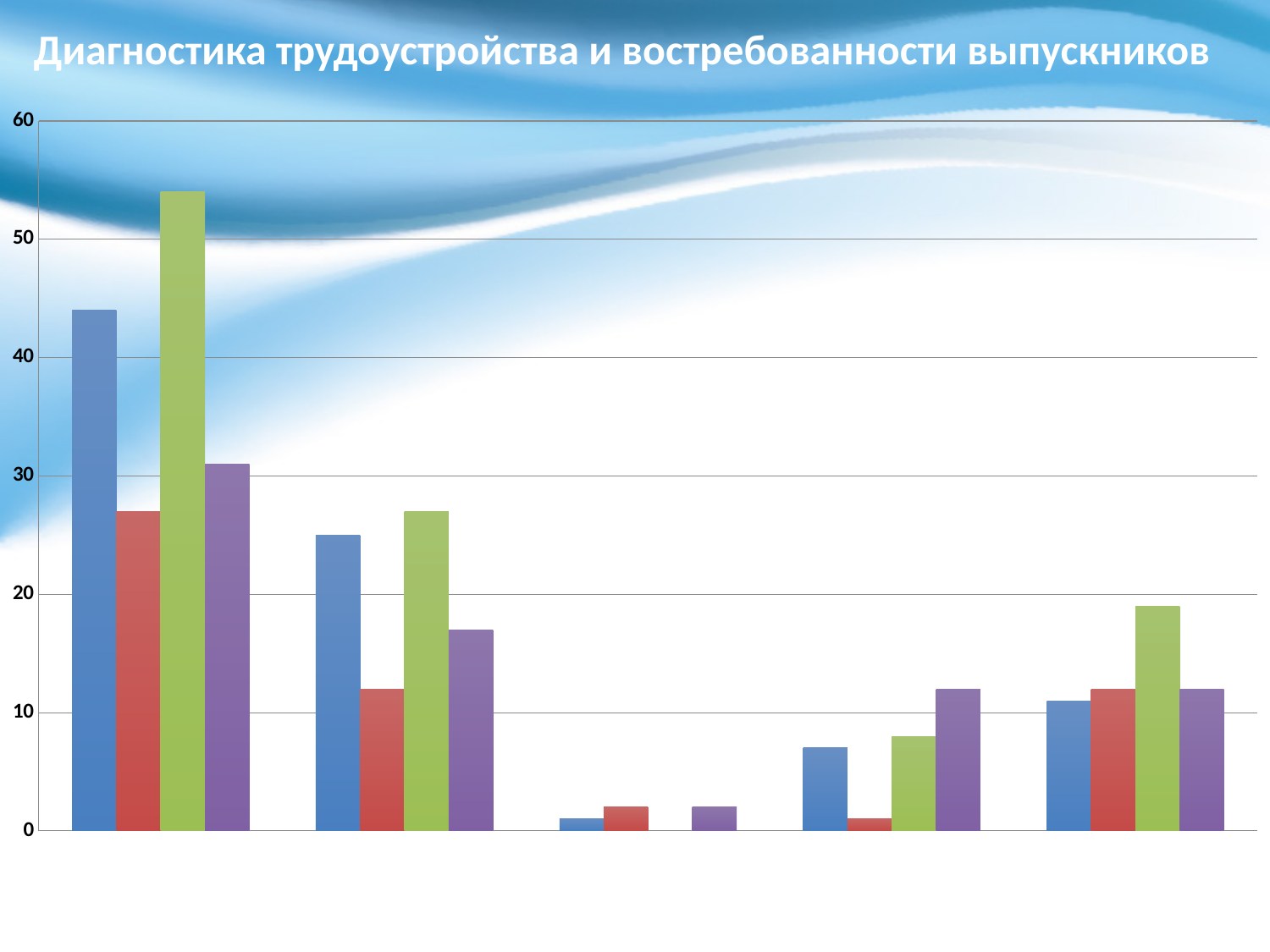
What is the title of the slide above the chart? Диагностика трудоустройства и востребованности выпускников Is the value of the green bar in the rightmost group greater or less than 20? less How many differently coloured bars (series) appear in each group? 4 In the second group from the left, which is taller: the blue bar or the purple bar? blue Is the value of the red bar in the second group from the left greater or less than 20? less Is the value of the blue bar in the first (leftmost) group greater or less than 40? greater Which group of bars has the lowest values overall? the third group (middle) Which coloured bar is the shortest in the fourth group from the left? red Which coloured bar is the tallest in the first (leftmost) group? green What kind of chart is shown on the slide? bar chart How many groups of bars are plotted along the x axis? 5